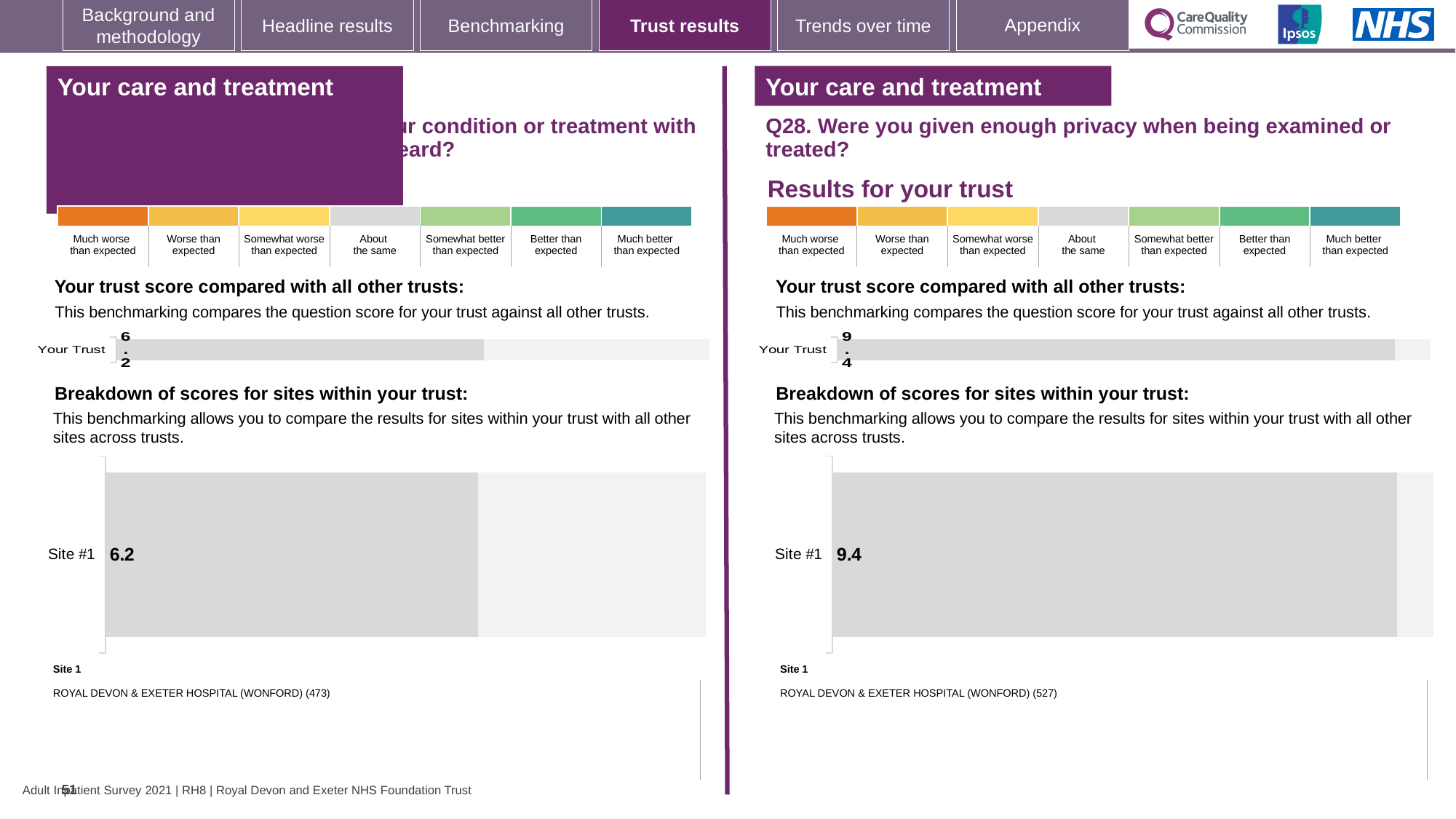
On the right-hand chart for Q28 (privacy when being examined or treated), what is the score shown for Your Trust? 9.4 How many sites are shown in the right-hand 'Breakdown of scores for sites within your trust' chart? 1 What kind of chart is used for the 'Breakdown of scores for sites within your trust' on the right-hand side of the slide? Bar chart What is the difference between the Site #1 score on the right-hand Q28 chart and the Site #1 score on the left-hand chart? 3.2 What number appears in brackets after the Site 1 hospital name beneath the right-hand Q28 breakdown chart? 527 Which is larger: the Your Trust score on the left-hand chart or the Your Trust score on the right-hand Q28 chart? The right-hand Q28 chart (9.4) On the left-hand 'Your trust score compared with all other trusts' chart, what is the score shown for Your Trust? 6.2 On the right-hand 'Breakdown of scores for sites within your trust' chart for Q28, what is the score for Site #1? 9.4 Which hospital is listed as Site 1 beneath the right-hand breakdown chart? ROYAL DEVON & EXETER HOSPITAL (WONFORD) On the right-hand Q28 charts, is the Site #1 score higher than, lower than, or equal to the Your Trust score? Equal On the left-hand 'Breakdown of scores for sites within your trust' chart, what is the score for Site #1? 6.2